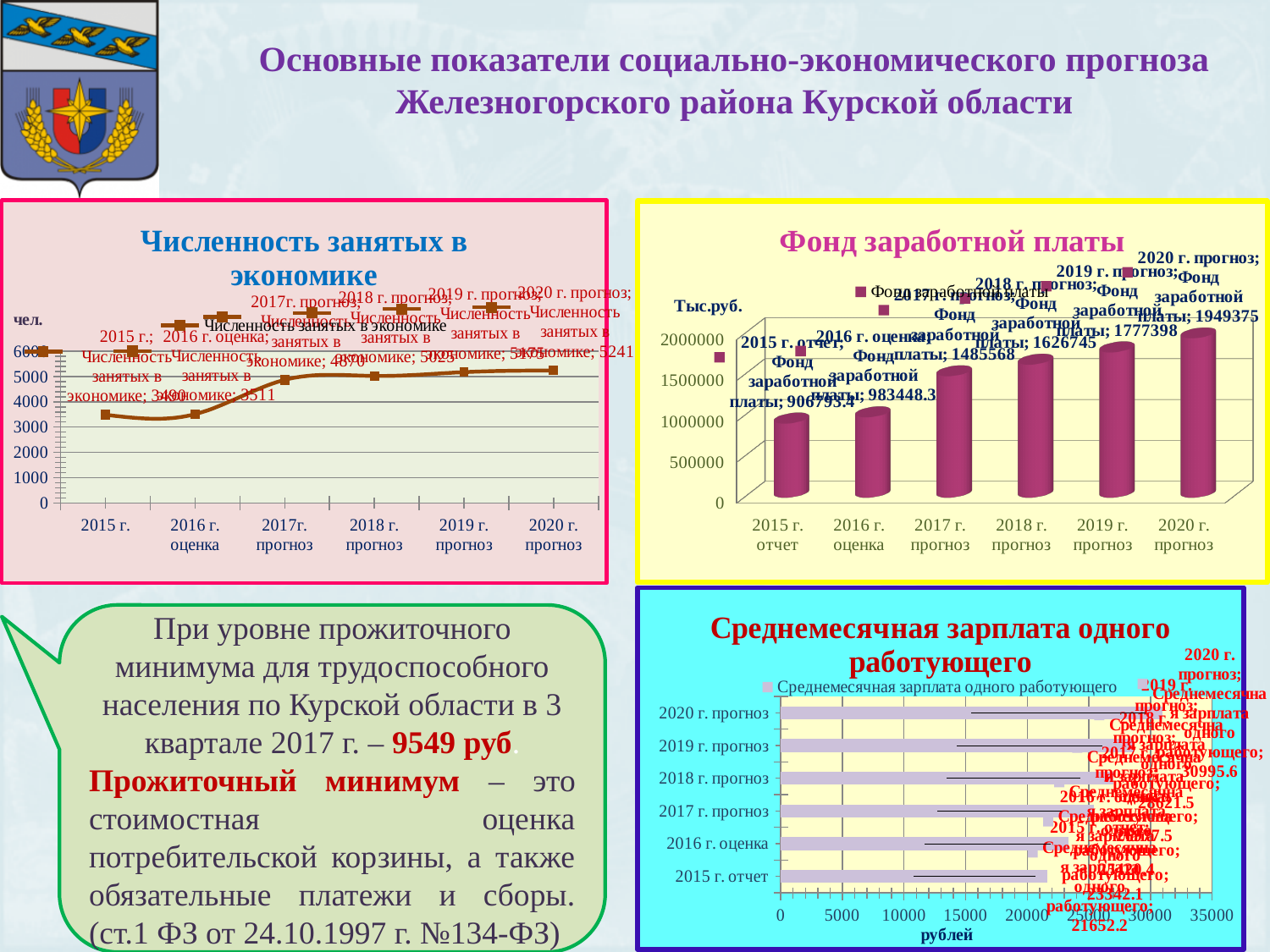
On the chart 'Численность занятых в экономике', what is the difference between the values for 2018 г. прогноз and 2016 г. оценка? 1514 On the chart 'Среднемесячная зарплата одного работующего', is the value for 2020 г. прогноз greater or less than 30000? greater On the chart 'Численность занятых в экономике', do the values rise or fall from 2015 г. to 2020 г. прогноз? rise On the chart 'Численность занятых в экономике', what is the value for 2015 г.? 3490 On the chart 'Фонд заработной платы', which year has the highest value? 2020 г. прогноз On the chart 'Фонд заработной платы', how many bars are plotted? 6 What kind of chart is 'Численность занятых в экономике'? line chart On the chart 'Фонд заработной платы', what is the value for 2015 г. отчет? 906793.4 On the chart 'Среднемесячная зарплата одного работующего', what is the value for 2015 г. отчет? 21652.2 On the chart 'Фонд заработной платы', what is the value for 2018 г. прогноз? 1626745 On the chart 'Численность занятых в экономике', what is the value for 2020 г. прогноз? 5241 On the chart 'Численность занятых в экономике', what is the value for 2017г. прогноз? 4870